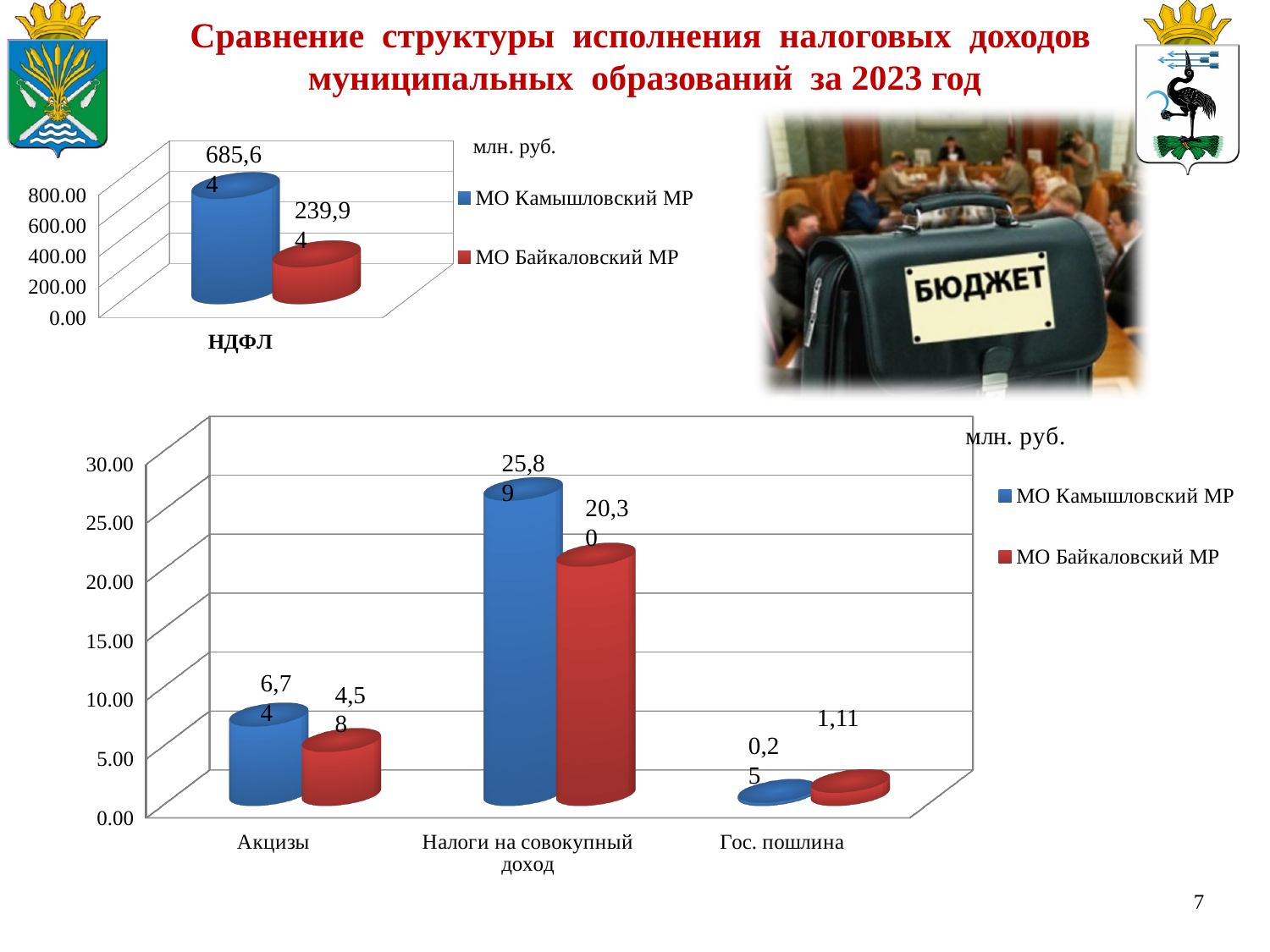
In the top chart (НДФЛ), which series has the larger value? МО Камышловский МР In the bottom chart, for Налоги на совокупный доход, which series has the larger value? МО Камышловский МР In the top chart (НДФЛ), is the value for МО Байкаловский МР greater or less than 400.00? less In the bottom chart, how many series does the legend list? 2 In the bottom chart, what is the value for МО Байкаловский МР for Гос. пошлина? 1,11 What type of chart is the bottom chart on the slide? bar chart In the bottom chart, for Гос. пошлина, which series has the larger value? МО Байкаловский МР In the bottom chart, how many categories are shown on the x axis? 3 In the bottom chart, is the value for МО Байкаловский МР for Налоги на совокупный доход greater or less than 15.00? greater What unit is indicated next to the legend of the bottom chart? млн. руб. In the bottom chart, which category has the lowest value for МО Байкаловский МР? Гос. пошлина In the bottom chart, which category has the highest value for МО Камышловский МР? Налоги на совокупный доход